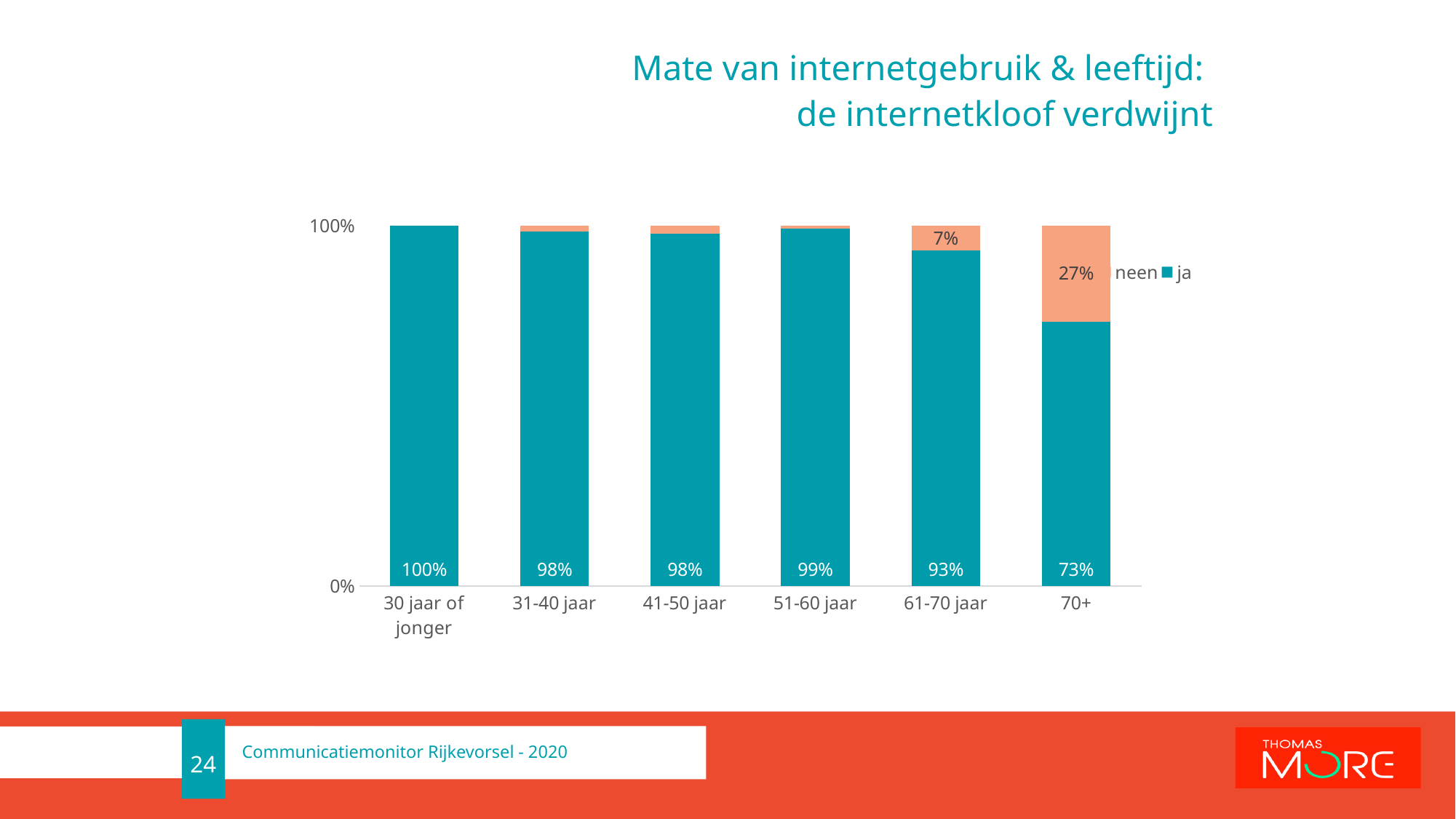
What is the title of the chart? Mate van internetgebruik & leeftijd: de internetkloof verdwijnt Which age group has the lowest 'ja' value? 70+ How many series does the legend list? 2 Which age group has the highest 'ja' value? 30 jaar of jonger Which is larger, the 'ja' value for 31-40 jaar or for 61-70 jaar? 31-40 jaar How many age groups are shown on the x axis? 6 What is the 'neen' value for the 61-70 jaar age group? 7% What is the difference between the 'ja' values for 61-70 jaar and 70+? 20% What kind of chart is shown on the slide? Stacked bar chart What is the 'neen' value for the 70+ age group? 27% What is the 'ja' value for the 70+ age group? 73% What is the 'ja' value for the 51-60 jaar age group? 99%